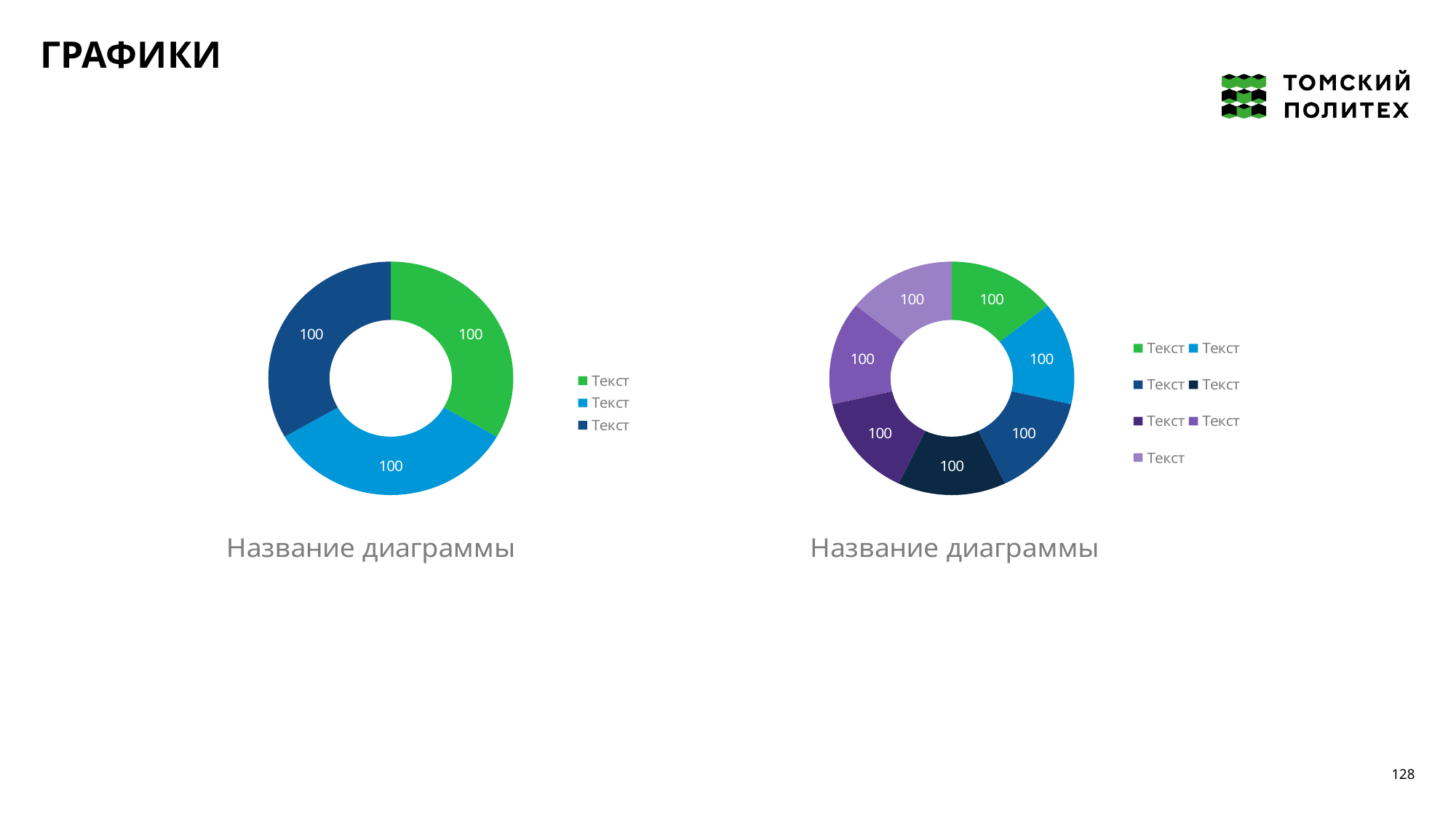
In the right chart, how many entries does the legend list? 7 In the left chart, what is the total of all slice values? 300 What kind of chart is the right chart on the slide? doughnut (pie) chart What kind of chart is the left chart on the slide? doughnut (pie) chart In the left chart, how many entries does the legend list? 3 In the left chart, how many slices does the doughnut have? 3 In the right chart, what is the total of all slice values? 700 In the left chart, what is the value of the green slice? 100 What is the title shown under the right chart? Название диаграммы In the left chart, is the light blue slice larger or smaller than the green slice, or are they equal? equal In the right chart, what is the value of the dark navy slice at the bottom? 100 In the right chart, how many slices does the doughnut have? 7